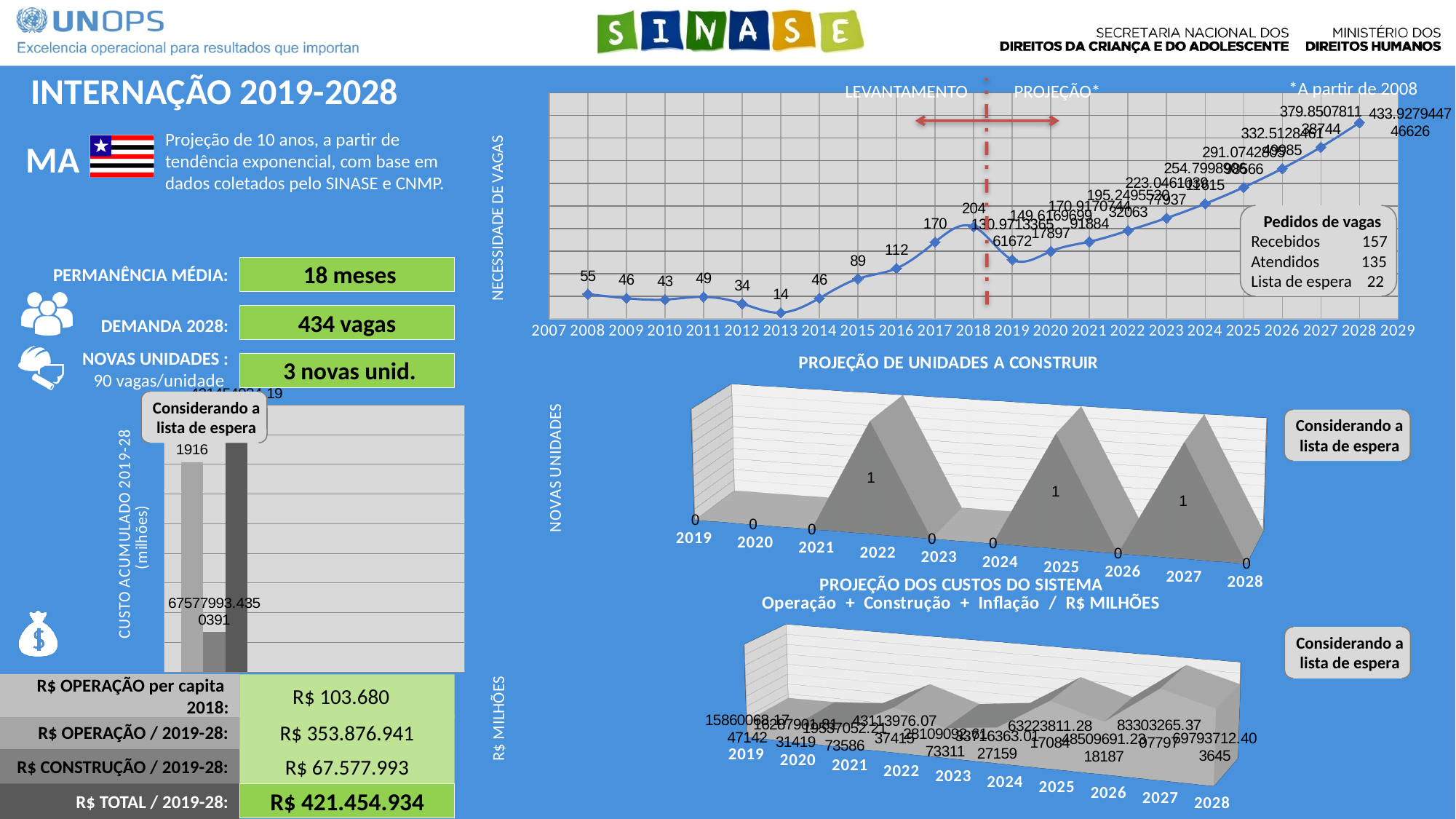
In the top line chart (NECESSIDADE DE VAGAS), what is the difference between the values for 2018 and 2017? 34 In the top line chart (NECESSIDADE DE VAGAS), what is the value for 2016? 112 In the top line chart (NECESSIDADE DE VAGAS), which year has the lowest value? 2013 What kind of chart is the top chart labelled NECESSIDADE DE VAGAS? line chart In the top line chart (NECESSIDADE DE VAGAS), what is the value for 2018? 204 In the chart titled PROJEÇÃO DE UNIDADES A CONSTRUIR, what is the value for 2022? 1 In the chart titled PROJEÇÃO DE UNIDADES A CONSTRUIR, how many years are shown on the x axis? 10 In the top line chart (NECESSIDADE DE VAGAS), what is the value for 2008? 55 In the top line chart (NECESSIDADE DE VAGAS), do the values rise or fall from 2013 to 2018? rise In the chart titled PROJEÇÃO DE UNIDADES A CONSTRUIR, how many years have a value of 1? 3 In the top line chart (NECESSIDADE DE VAGAS), which year has the larger value, 2014 or 2015? 2015 In the top line chart (NECESSIDADE DE VAGAS), what is the value for 2013? 14